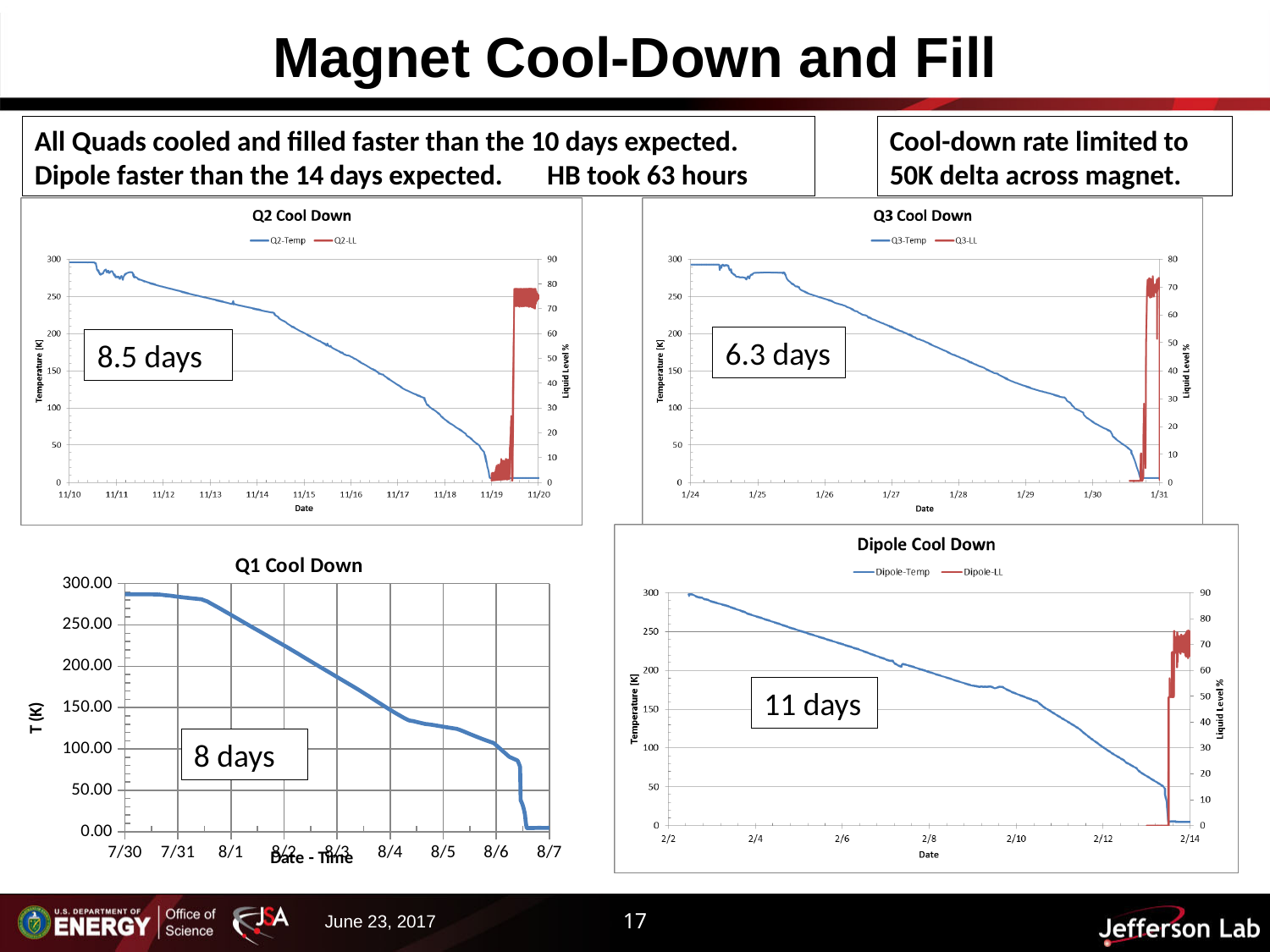
On the Dipole Cool Down chart, is the Dipole-Temp value on 2/10 greater or less than 150? greater How many series does the legend of the Q2 Cool Down chart list? 2 On the Q1 Cool Down chart, does the temperature rise or fall from 7/30 to 8/7? fall On the Q1 Cool Down chart, is the temperature on 8/2 greater or less than 200.00? greater What kind of chart is the Q2 Cool Down chart? line chart On the Q3 Cool Down chart, is the Q3-Temp value on 1/26 greater or less than 200? greater What are the legend entries on the Dipole Cool Down chart? Dipole-Temp, Dipole-LL How many series does the legend of the Q3 Cool Down chart list? 2 What duration is annotated on the Dipole Cool Down chart? 11 days On the Q1 Cool Down chart, which is larger: the temperature on 7/30 or on 8/6? 7/30 On the Dipole Cool Down chart, does the Dipole-Temp line rise or fall from 2/2 to 2/14? fall